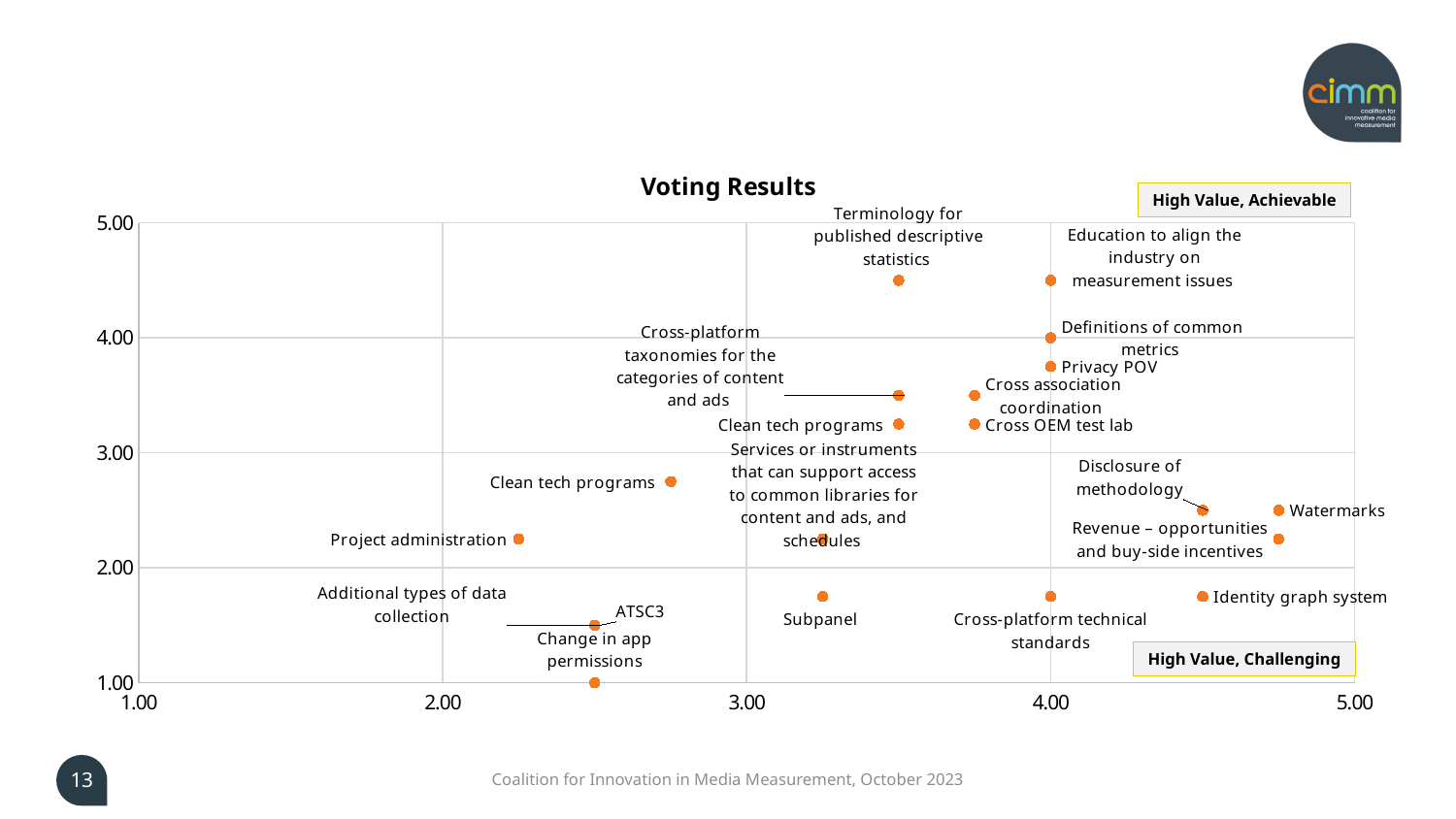
What is the y-axis value of the point labelled Change in app permissions? 1.00 Is the vertical (y-axis) value for Terminology for published descriptive statistics greater or less than 4.00? greater What label appears in the box at the top right corner of the chart area? High Value, Achievable Which labelled point has the lowest vertical (y-axis) value? Change in app permissions What is the title of the chart? Voting Results Is the horizontal (x-axis) value for Watermarks greater or less than 4.00? greater What kind of chart is shown on the slide? scatter chart Is the horizontal (x-axis) value for Project administration greater or less than 3.00? less Which point has the larger horizontal (x-axis) value, Watermarks or Project administration? Watermarks